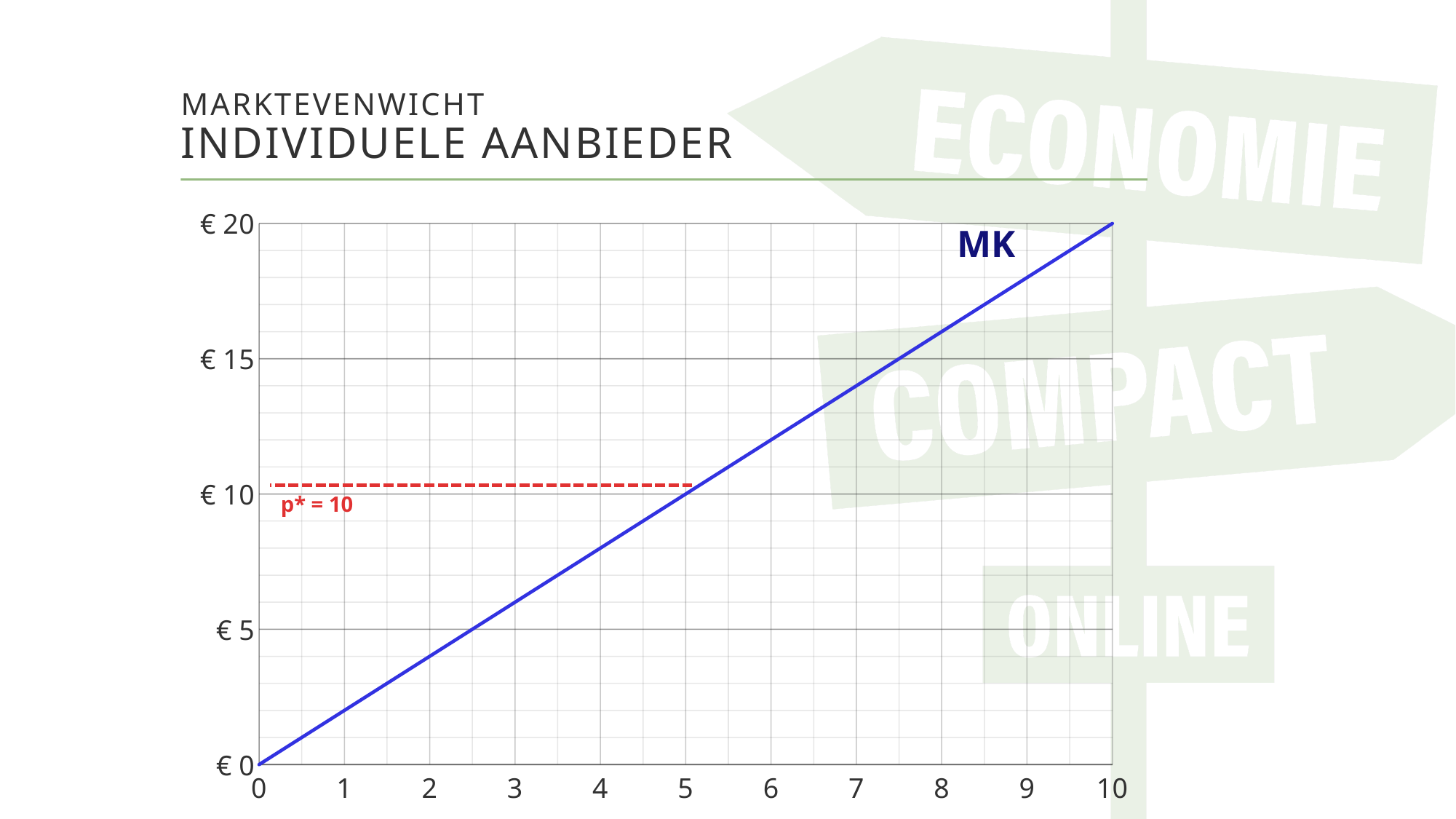
What is the value of the MK line at x = 10? € 20 What is the value of the MK line at x = 0? € 0 Is the value of the MK line at x = 7 greater or less than € 10? greater What is the highest value shown on the y-axis? € 20 What is the label of the blue line in the chart? MK Does the MK line rise or fall as the x-axis value increases? rises Is the value of the MK line at x = 2 greater or less than € 5? less What value of p* is indicated by the red dashed line? p* = 10 What is the value of the MK line at x = 5? € 10 What kind of chart is shown on the slide? line chart How many tick marks are labelled on the x-axis? 11 Is the value of the MK line at x = 8 greater or less than € 15? greater